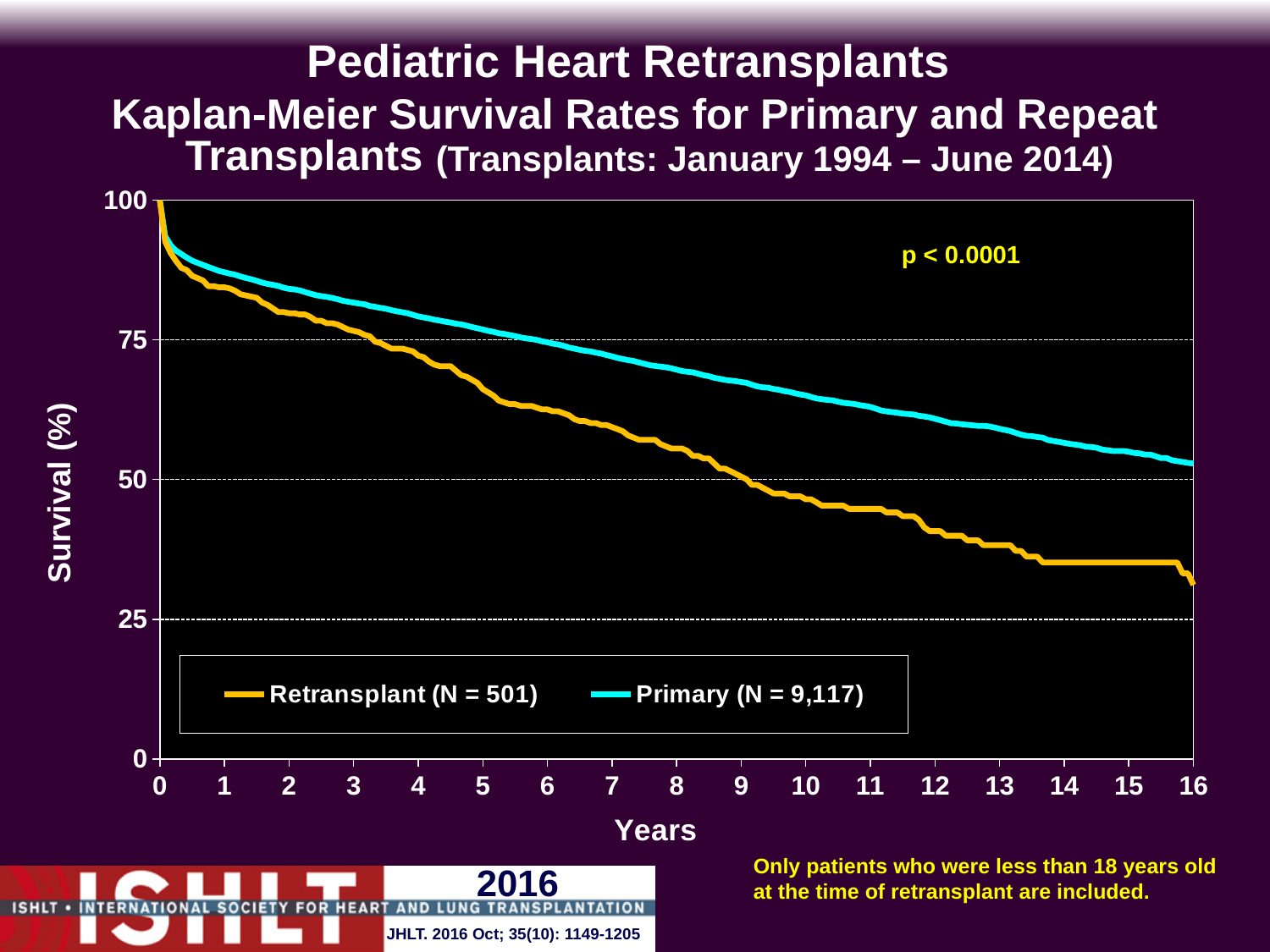
Is the Retransplant survival at year 6 greater or less than 75? less What p-value is printed on the chart? p < 0.0001 What is the N for the Retransplant series in the legend? 501 Is the Retransplant survival at year 16 greater or less than 50? less Do the survival curves rise or fall as years increase? fall At year 10, which series has the higher survival, Retransplant or Primary? Primary Is the Primary survival at year 8 greater or less than 50? greater What is the highest value shown on the x axis (Years)? 16 How many series does the legend list? 2 What kind of chart is shown on the slide? line chart